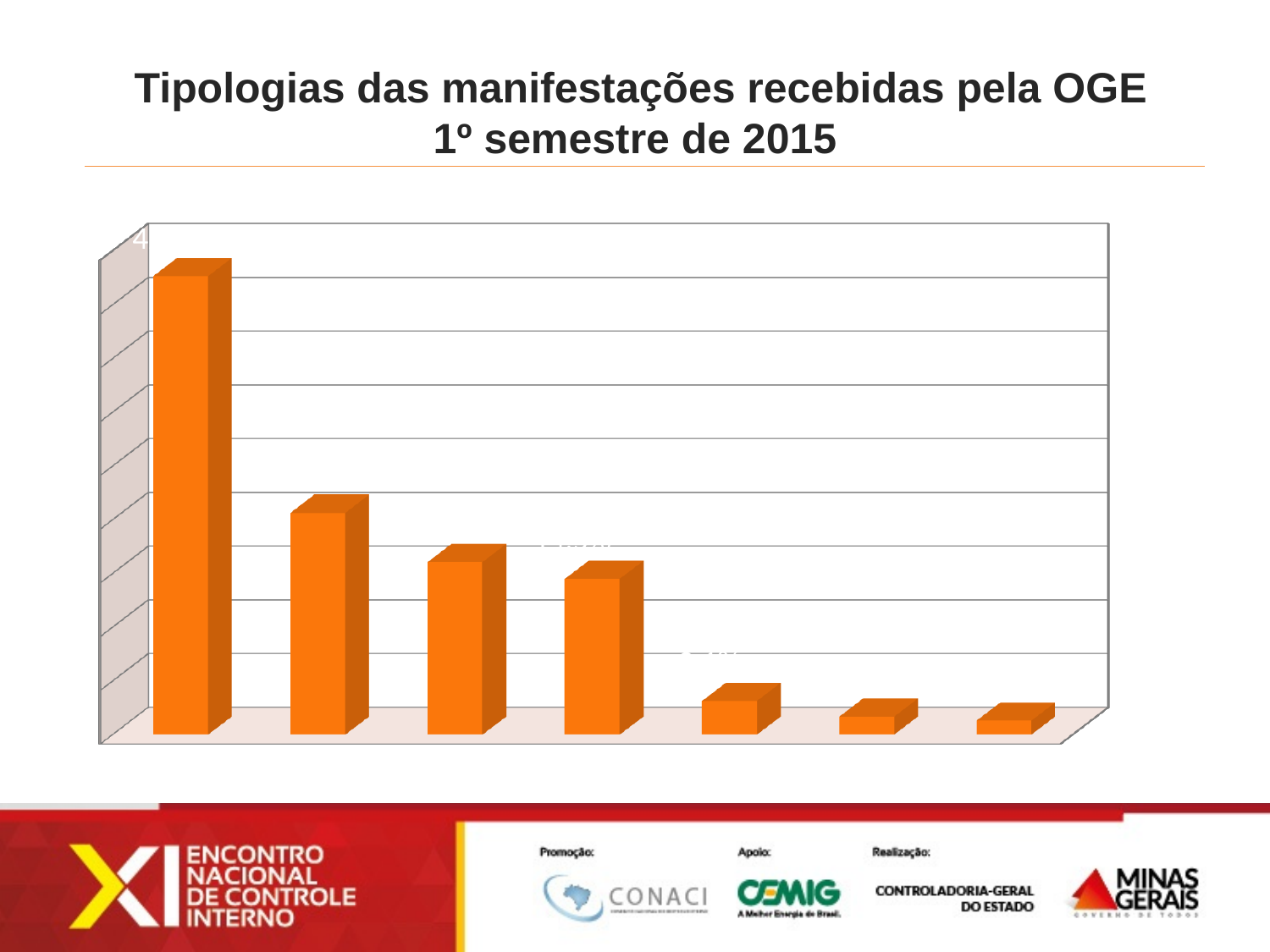
Do the bar values rise or fall from left to right across the chart? fall Which bar is the tallest in the chart? the first bar from the left What colour are the bars in the chart? orange What is the title of the chart on the slide? Tipologias das manifestações recebidas pela OGE 1º semestre de 2015 What kind of chart is shown on the slide? bar chart Which bar is the shortest in the chart? the last bar on the right Which is larger, the second bar from the left or the third bar from the left? the second bar from the left Which is larger, the fourth bar from the left or the fifth bar from the left? the fourth bar from the left How many bars does the chart contain? 7